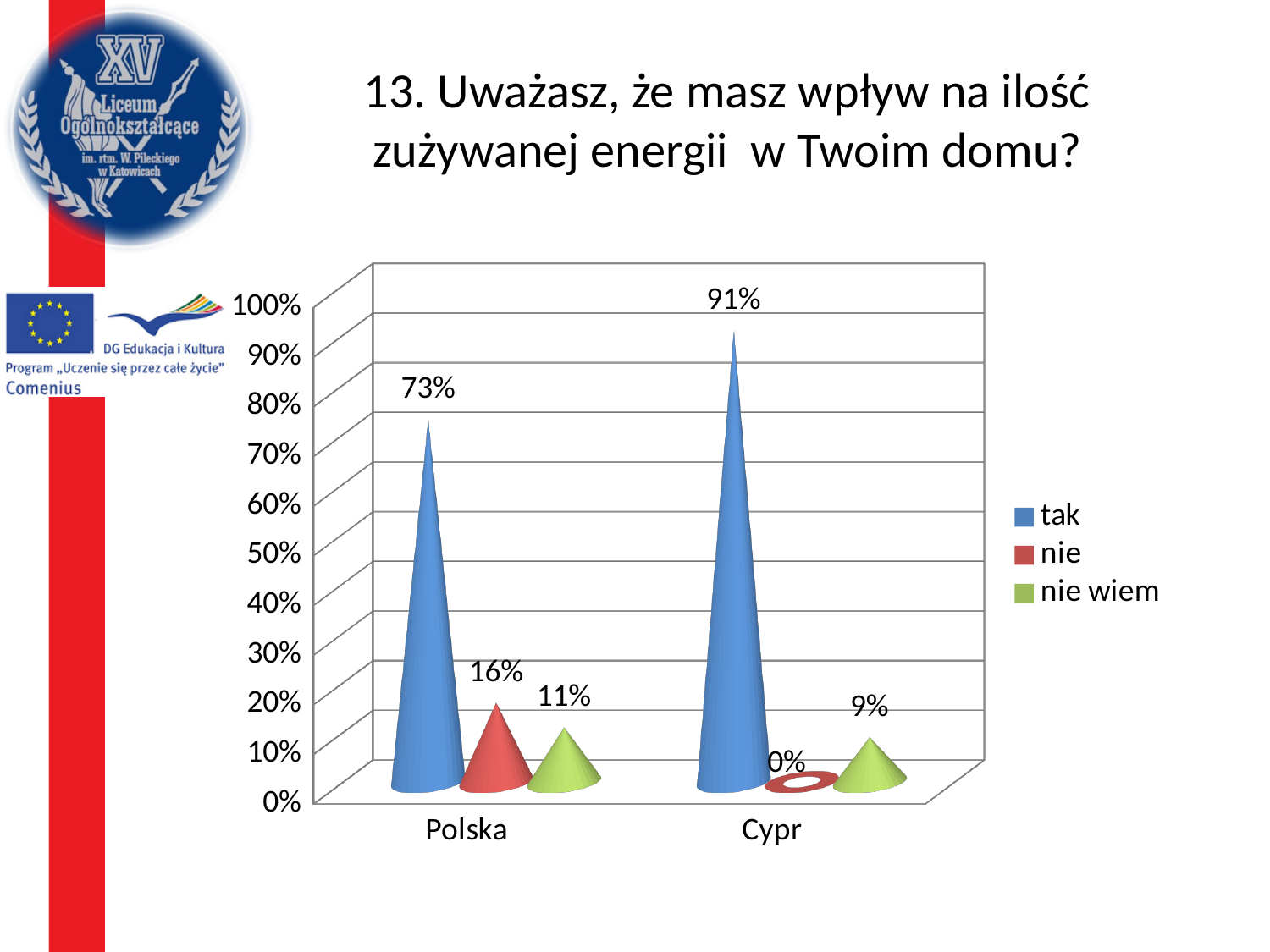
What is the value for "tak" for Cypr? 91% What is the difference between the "tak" values for Cypr and Polska? 18% What is the value for "nie wiem" for Cypr? 9% Which country has the higher value for "tak"? Cypr What is the value for "nie" for Cypr? 0% Which series has the lowest value for Polska? nie wiem What is the difference between the "nie" values for Polska and Cypr? 16% How many series does the legend list? 3 How many categories are shown on the x axis? 2 What kind of chart is shown on the slide? bar chart What is the value for "tak" for Polska? 73% What is the value for "nie" for Polska? 16%